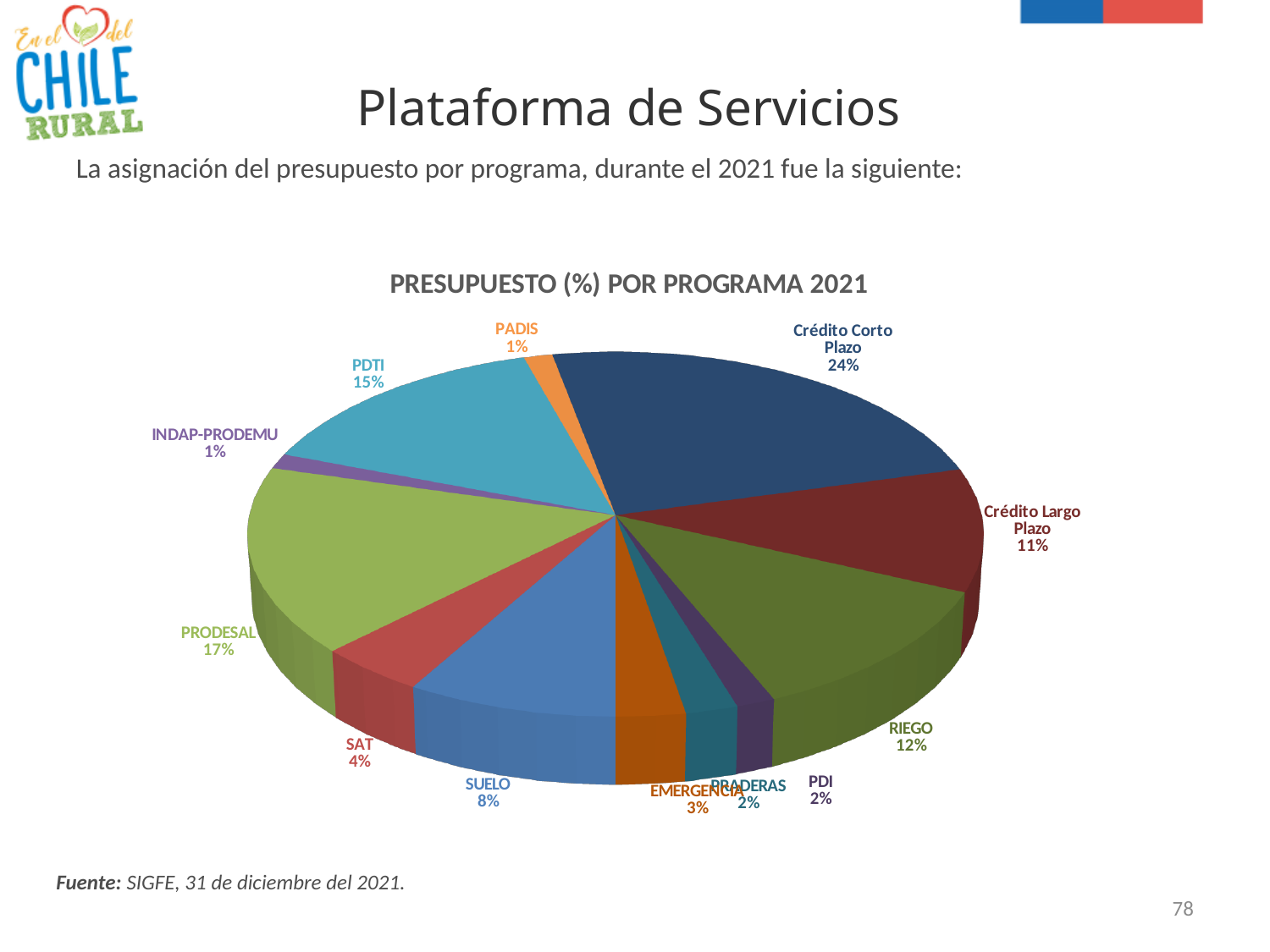
What percentage is shown for SUELO? 8% What percentage is shown for RIEGO? 12% Which program has the largest share of the budget? Crédito Corto Plazo How many programs (slices) are shown in the pie chart? 12 What percentage is shown for EMERGENCIA? 3% Which has a larger share, PRODESAL or PDTI? PRODESAL What share of the budget does PRODESAL receive? 17% What is the combined share of PDI and PRADERAS? 4% What type of chart is shown on the slide? Pie chart What percentage of the 2021 budget is allocated to Crédito Corto Plazo? 24% What is the title of the chart? PRESUPUESTO (%) POR PROGRAMA 2021 What is the difference in percentage points between Crédito Corto Plazo and Crédito Largo Plazo? 13